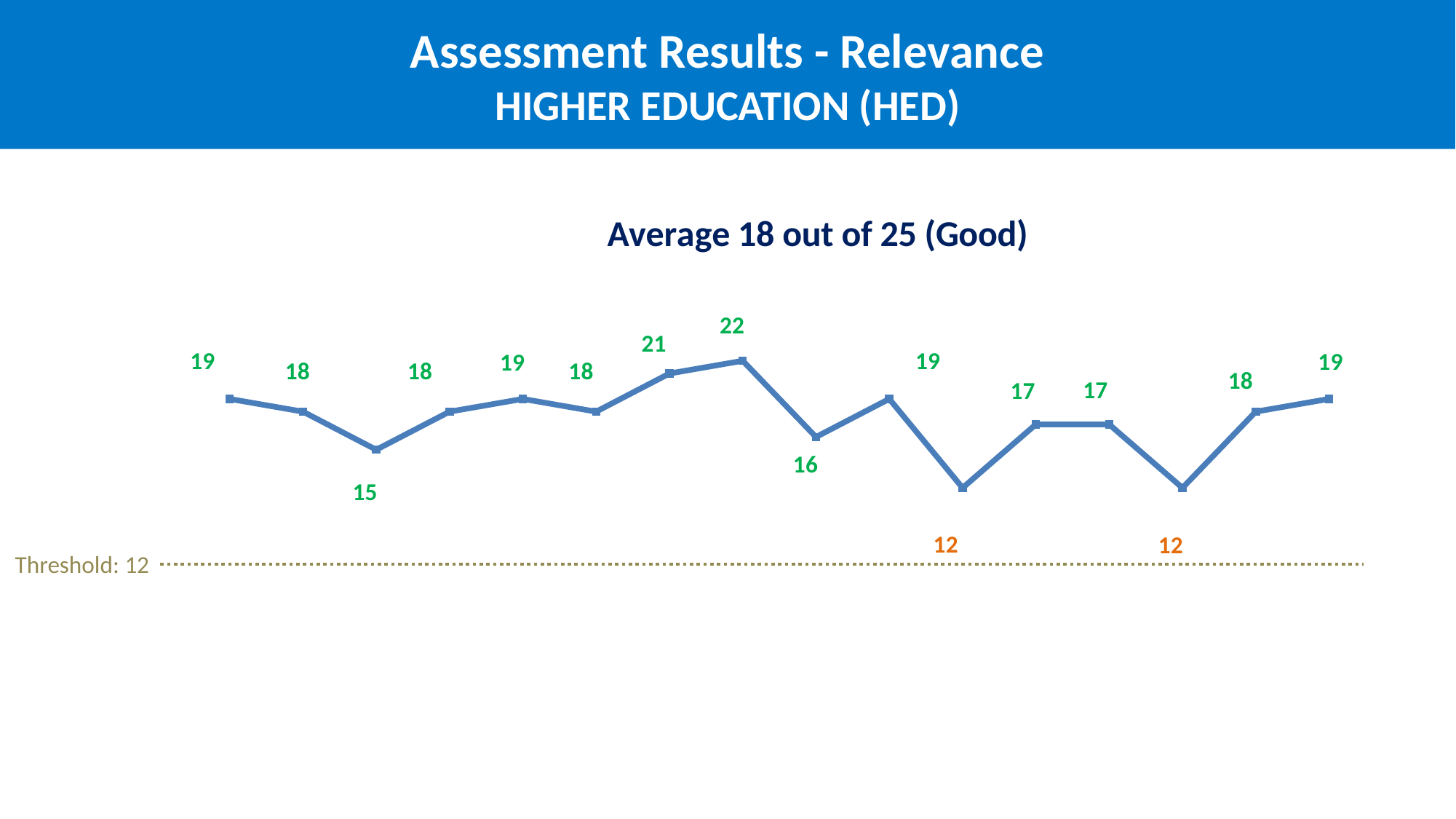
What kind of chart is shown on the slide? line chart What threshold value is marked by the dotted line? 12 What is the value of the first point on the line? 19 What is the difference between the highest value (22) and the lowest value (12) on the line? 10 What is the value of the third point on the line? 15 What is the highest value plotted on the line? 22 What is the lowest value plotted on the line? 12 Which is larger, the value of the seventh point or the value of the ninth point? the seventh point (21) What average score is stated above the chart? 18 out of 25 (Good) What is the value of the last point on the line? 19 How many points on the line have a value of 12? 2 How many data points are plotted on the line? 16